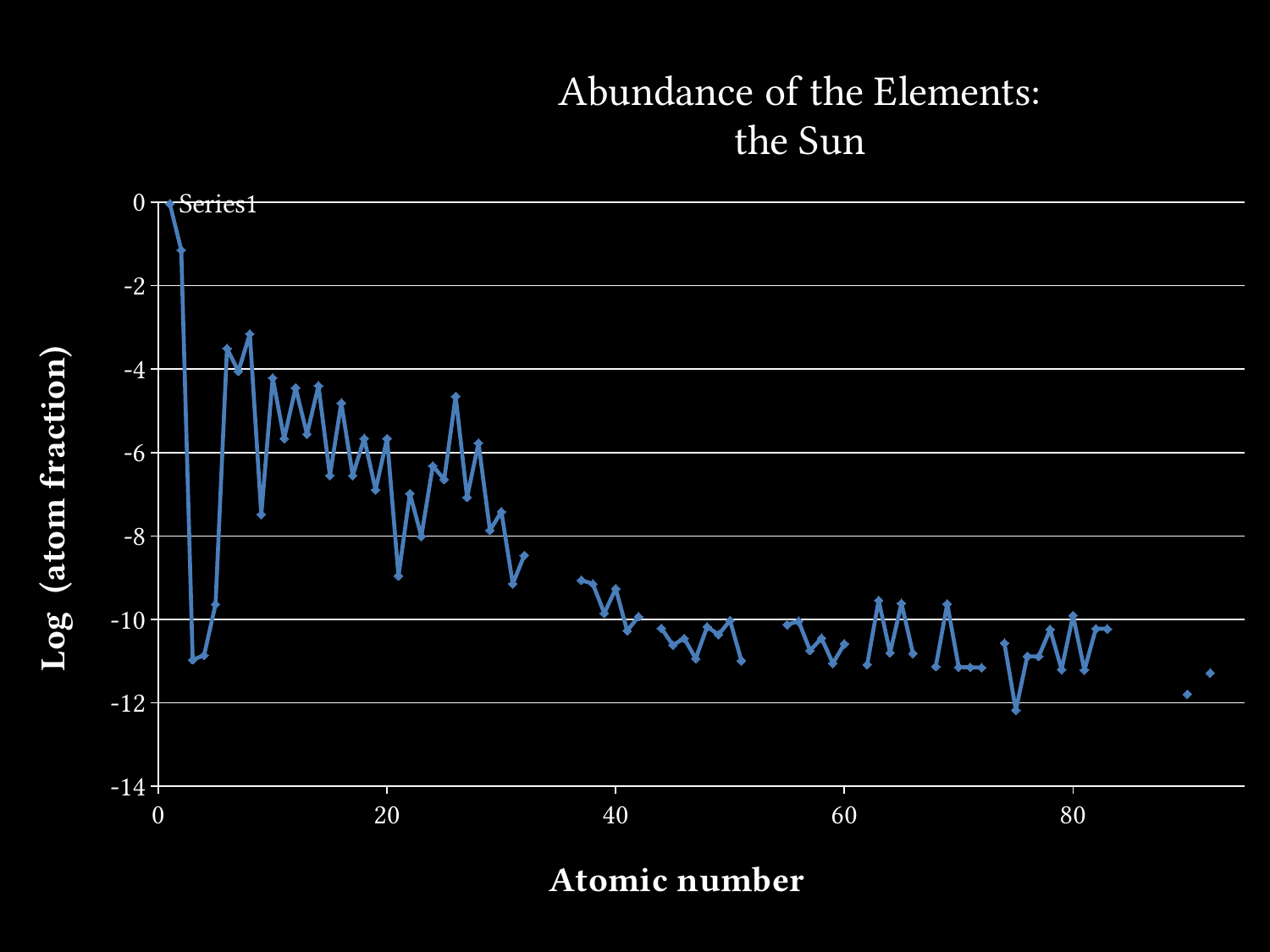
Is the value at atomic number 40 greater or less than -8? less Is the value at atomic number 2 greater or less than -2? greater Is the value at atomic number 26 greater or less than -6? greater Which has the larger value, atomic number 26 or atomic number 25? atomic number 26 Overall, do the values rise or fall as the atomic number increases? fall What is the title of the chart? Abundance of the Elements: the Sun What kind of chart is shown on the slide? line chart At which atomic number is the log atom fraction highest? 1 Which has the larger value, atomic number 1 or atomic number 2? atomic number 1 What is the label of the x axis? Atomic number